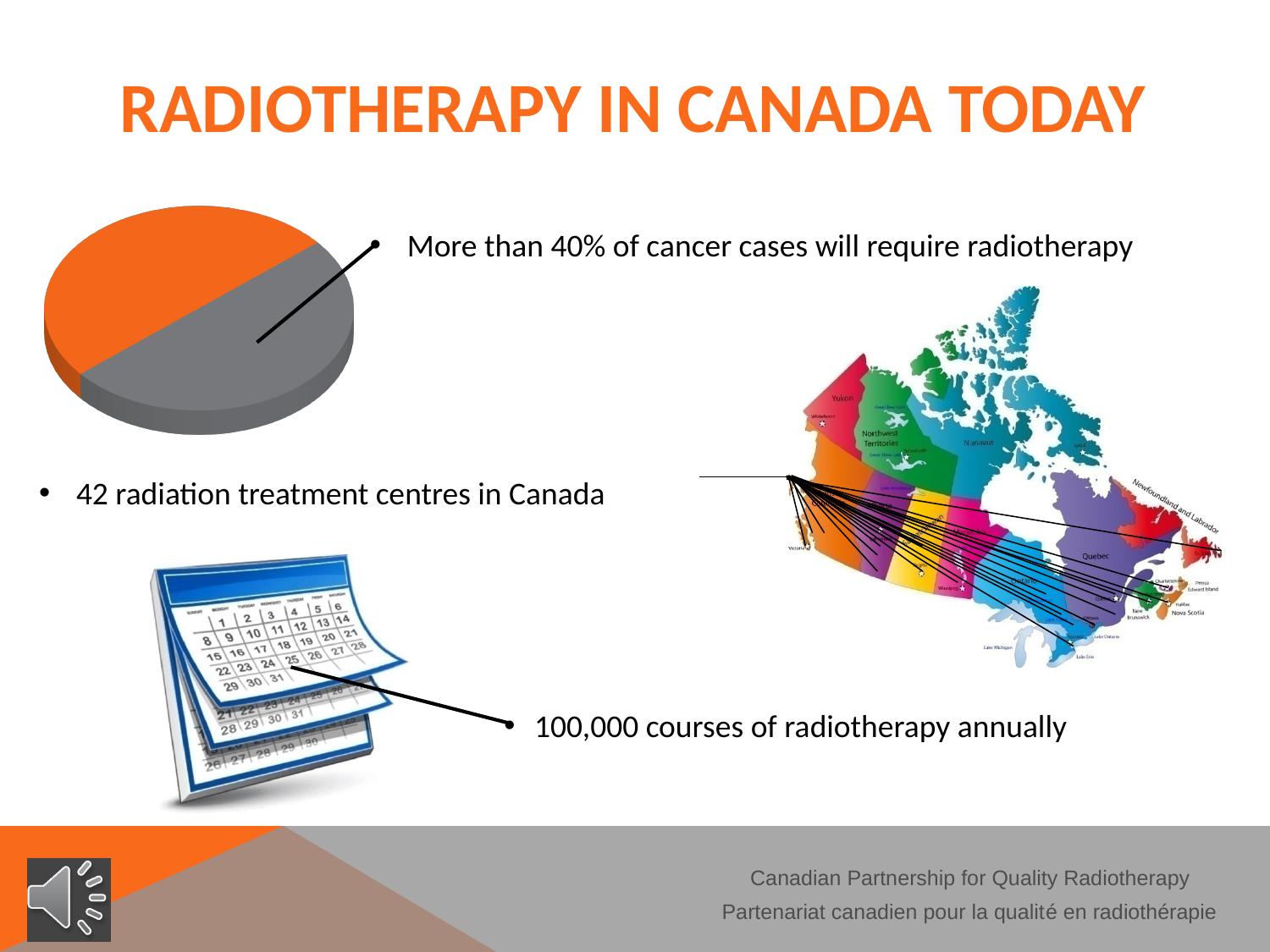
What two colours are used for the slices of the pie chart? orange and grey Which slice of the pie chart is larger, the orange one or the grey one? Neither; the two slices are equal Which slice of the pie chart is the smallest? Neither; both slices are equal in size Does the pie chart display a legend? No How many slices does the pie chart have? 2 Which slice of the pie chart is the largest? Neither; both slices are equal in size What kind of chart is shown on the left of the slide? pie chart